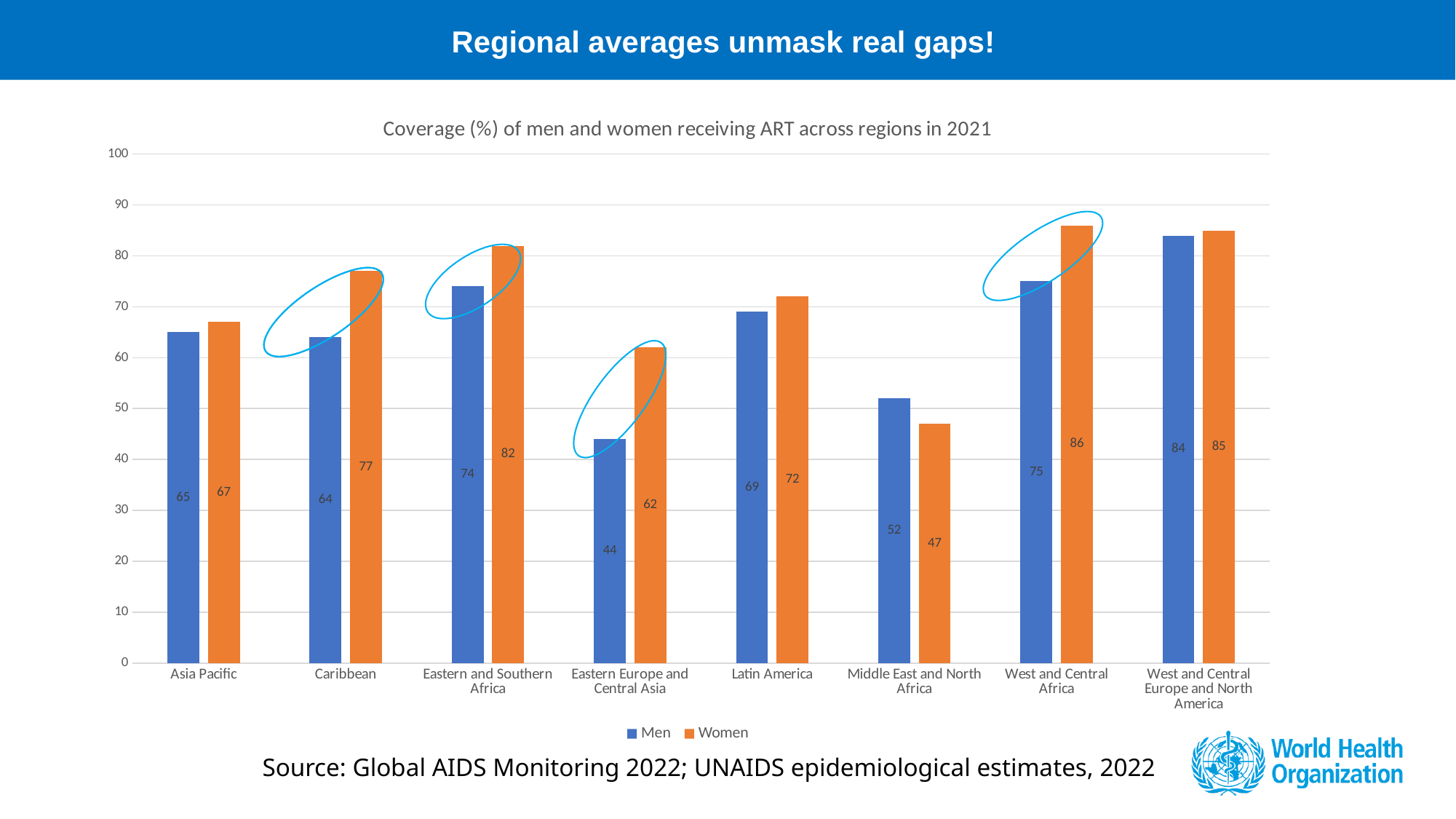
How many series does the legend list? 2 Which region has the lowest value for Men? Eastern Europe and Central Asia What is the ART coverage value for Women in the Caribbean? 77 In Middle East and North Africa, which is larger, the value for Men or for Women? Men What kind of chart is shown on the slide? Bar chart What is the difference between the Women and Men values in the Caribbean? 13 What is the difference between the Women and Men values in Eastern Europe and Central Asia? 18 What is the ART coverage value for Women in West and Central Africa? 86 How many regions are shown on the x axis? 8 What is the ART coverage value for Men in Eastern Europe and Central Asia? 44 Which region has the highest value for Women? West and Central Africa What is the title of the chart? Coverage (%) of men and women receiving ART across regions in 2021